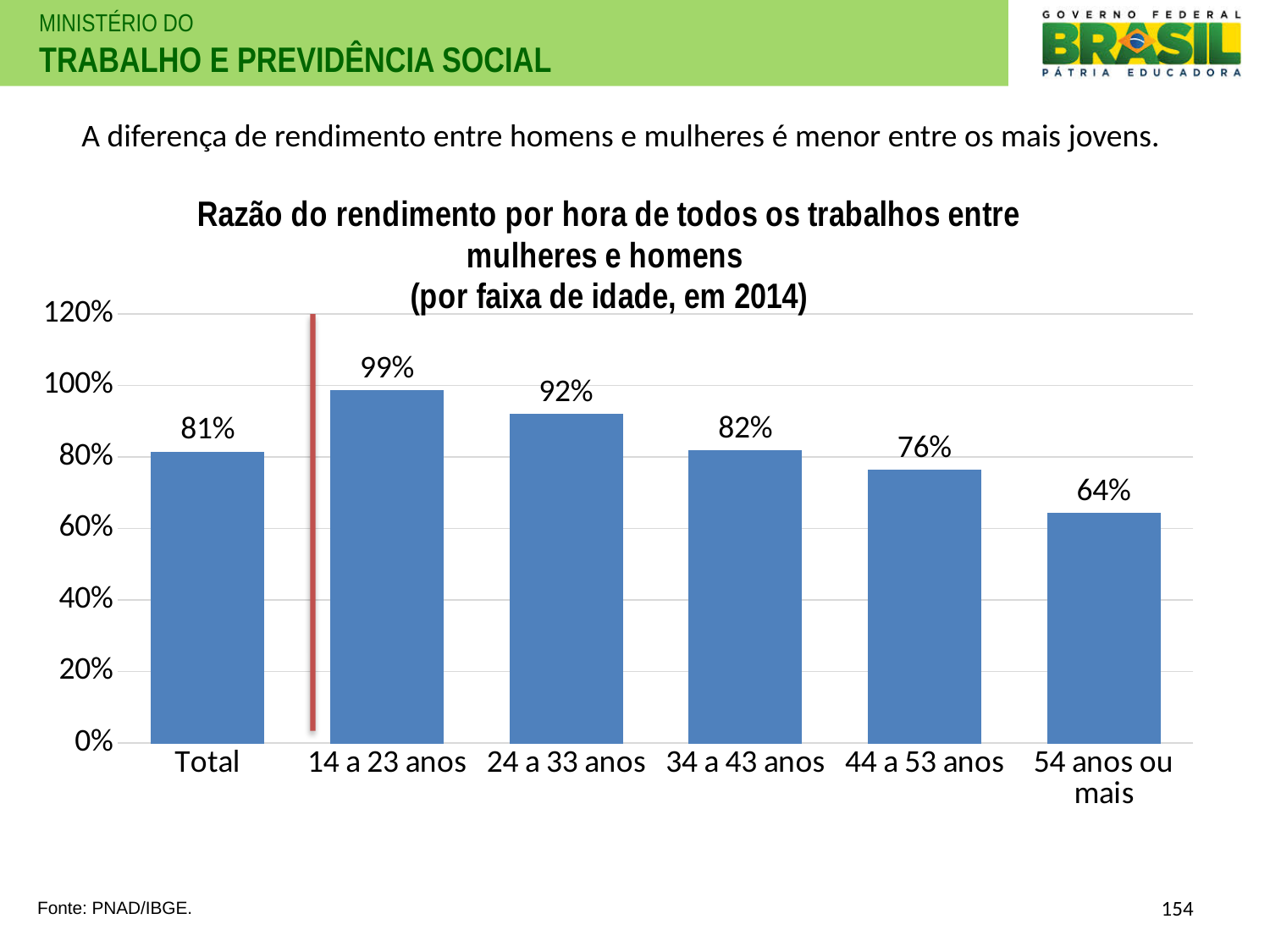
How many categories are shown on the x axis? 6 What kind of chart is shown on the slide? Bar chart What year does the chart title say the data refers to? 2014 Is the value for "34 a 43 anos" greater or less than 80%? greater Do the values rise or fall across the age groups from "14 a 23 anos" to "54 anos ou mais"? Fall What is the difference between the values for "14 a 23 anos" and "54 anos ou mais"? 35% Which category has the highest value? 14 a 23 anos Which category has the lowest value? 54 anos ou mais What is the value for the "54 anos ou mais" age group? 64% What is the value for the "14 a 23 anos" age group? 99% What is the value for "Total"? 81% Which is larger, the value for "24 a 33 anos" or for "44 a 53 anos"? 24 a 33 anos